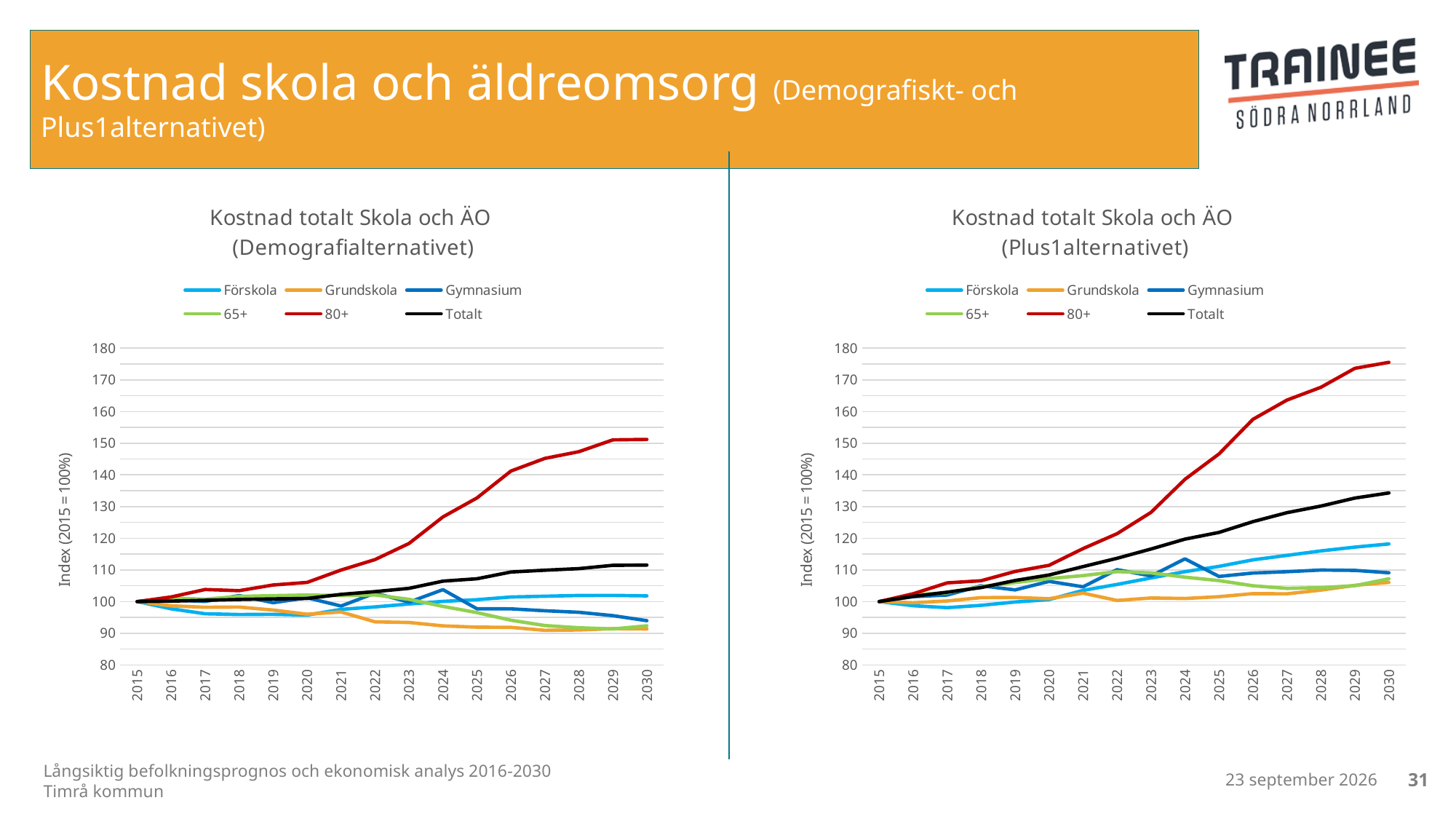
How many years are shown on the x axis of the left chart (Demografialternativet)? 16 In the right chart (Plus1alternativet), which series has the highest value in 2030? 80+ In the right chart (Plus1alternativet), is the value for 80+ in 2030 greater or less than 170? greater In the left chart (Demografialternativet), what is the index value of Totalt in 2015? 100 What kind of chart is the left chart, 'Kostnad totalt Skola och ÄO (Demografialternativet)'? line chart In the left chart (Demografialternativet), which is larger in 2030: Förskola or Gymnasium? Förskola Does the Grundskola series in the left chart (Demografialternativet) generally rise or fall from 2015 to 2030? fall In the left chart (Demografialternativet), which series has the highest value in 2030? 80+ In the left chart (Demografialternativet), is the value for Totalt in 2030 greater or less than 120? less In the right chart (Plus1alternativet), is the value for Förskola in 2030 greater or less than 110? greater What is the y-axis label of the right chart (Plus1alternativet)? Index (2015 = 100%) How many series does the legend of the right chart, 'Kostnad totalt Skola och ÄO (Plus1alternativet)', list? 6